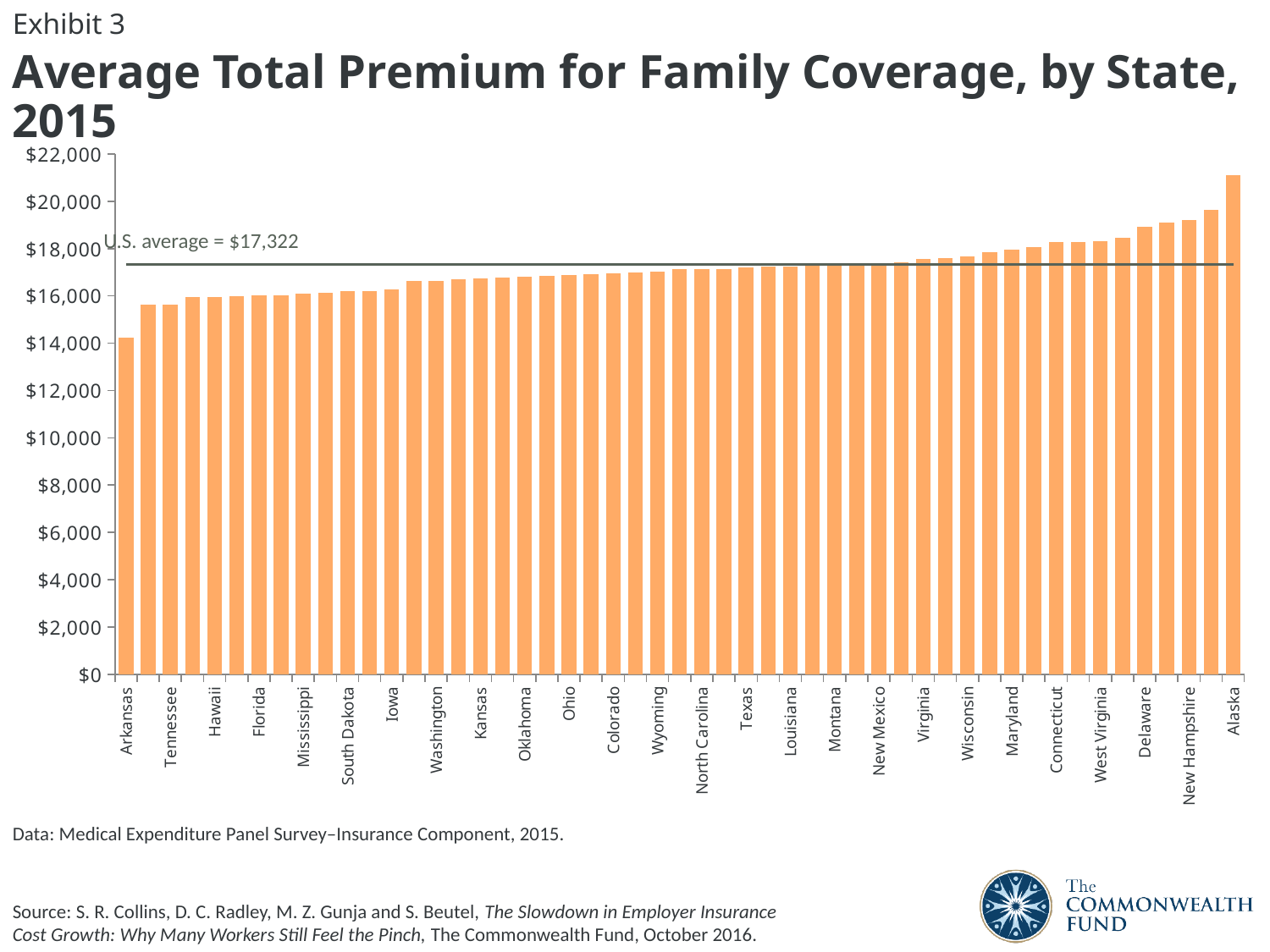
What is the U.S. average premium shown on the chart? $17,322 Do the bar values rise or fall moving from left to right along the x axis? rise Is the value for Delaware greater or less than $18,000? greater What kind of chart is shown on the slide? bar chart What is the title of the chart? Average Total Premium for Family Coverage, by State, 2015 Which state has the lowest average total premium for family coverage? Arkansas Is the value for Arkansas greater or less than $16,000? less Which has a higher average total premium, Tennessee or New Hampshire? New Hampshire Which state has the highest average total premium for family coverage? Alaska Is the value for Alaska greater or less than $20,000? greater